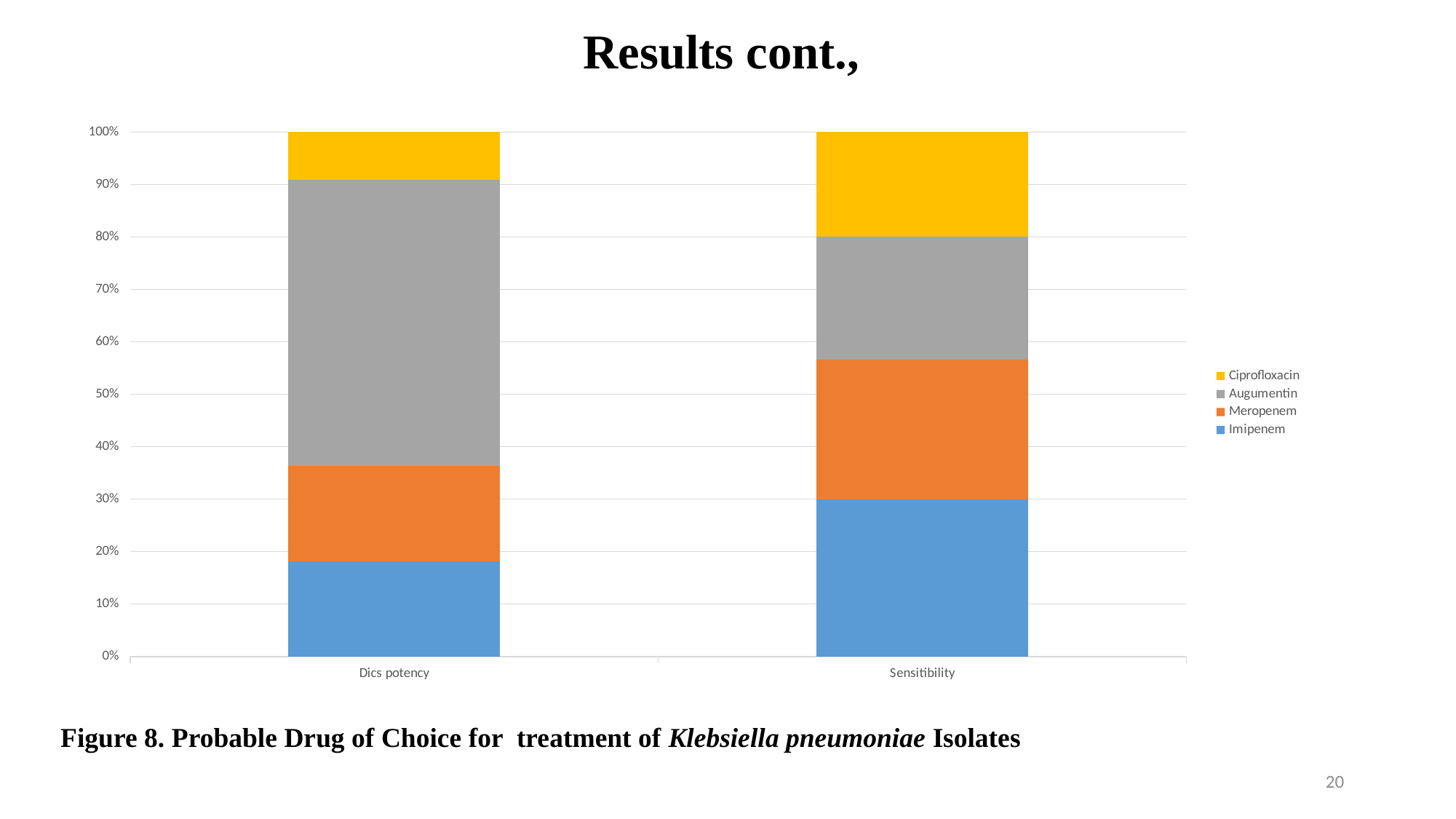
Is the Augumentin segment larger in the Dics potency bar or the Sensibility bar? Dics potency What kind of chart is shown on the slide? Stacked bar chart Is the value for Imipenem in the Dics potency bar greater or less than 20%? less What is the total of the Sensibility stacked bar? 100% Which series has the smallest segment in the Dics potency bar? Ciprofloxacin How many categories are shown on the x axis? 2 How many series does the legend list? 4 Is the Ciprofloxacin segment larger in the Dics potency bar or the Sensibility bar? Sensibility Which colour represents Imipenem in the legend? Blue Is the value for Augumentin in the Dics potency bar greater or less than 50%? greater Which series has the largest segment in the Dics potency bar? Augumentin What is the value for Imipenem in the Sensibility bar? 30%